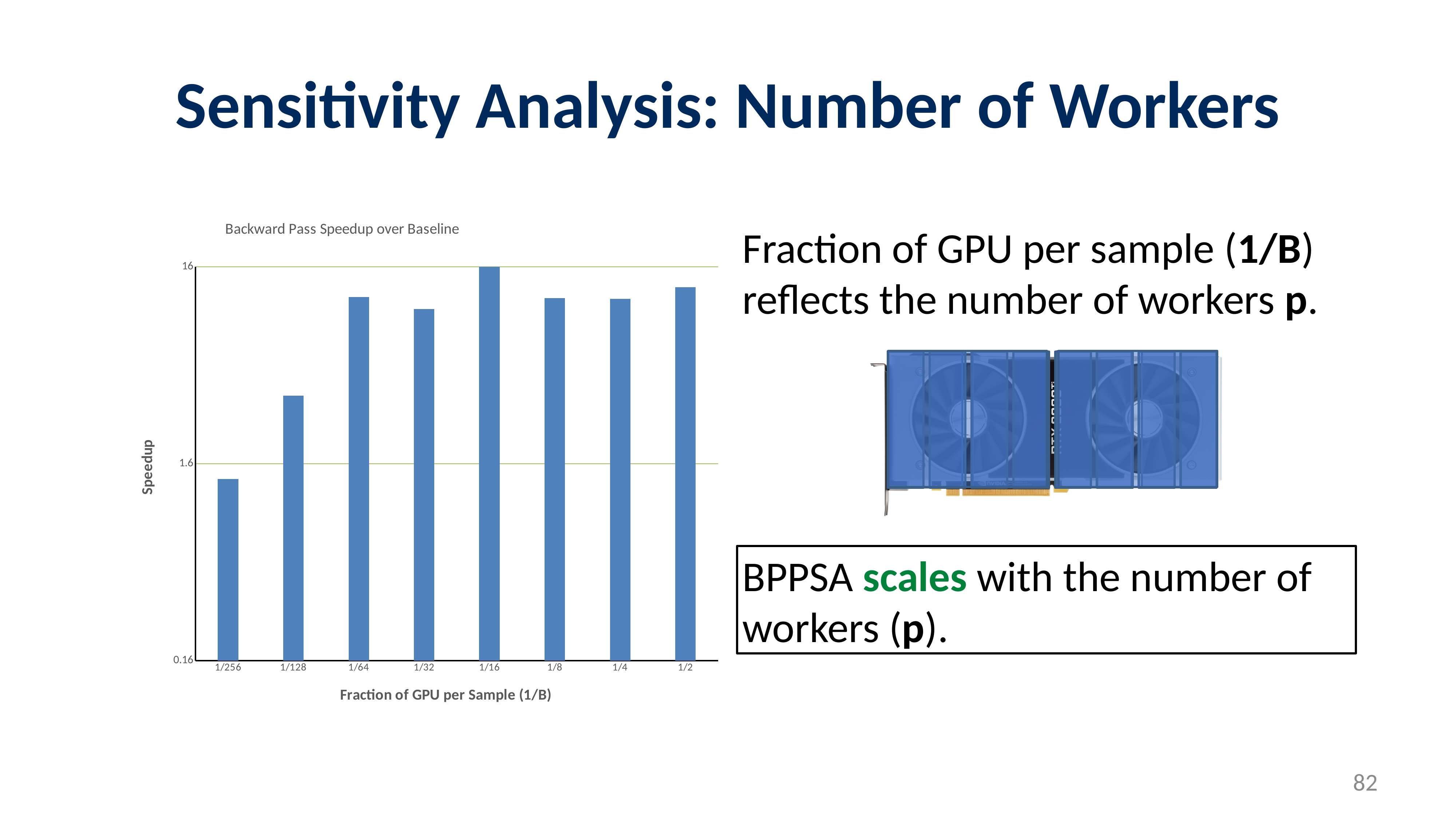
Is the speedup for 1/128 greater or less than 1.6? greater Is the speedup for 1/2 greater or less than 16? less What is the title of the chart? Backward Pass Speedup over Baseline Which has the larger speedup, 1/128 or 1/64? 1/64 Which fraction of GPU per sample has the highest speedup? 1/16 How many bars are plotted in the chart? 8 What type of chart is shown on the slide? bar chart Which fraction of GPU per sample has the lowest speedup? 1/256 Do the speedup values rise or fall from 1/256 to 1/16 along the x axis? rise Is the speedup for 1/256 greater or less than 1.6? less What is the label of the x axis of the chart? Fraction of GPU per Sample (1/B)